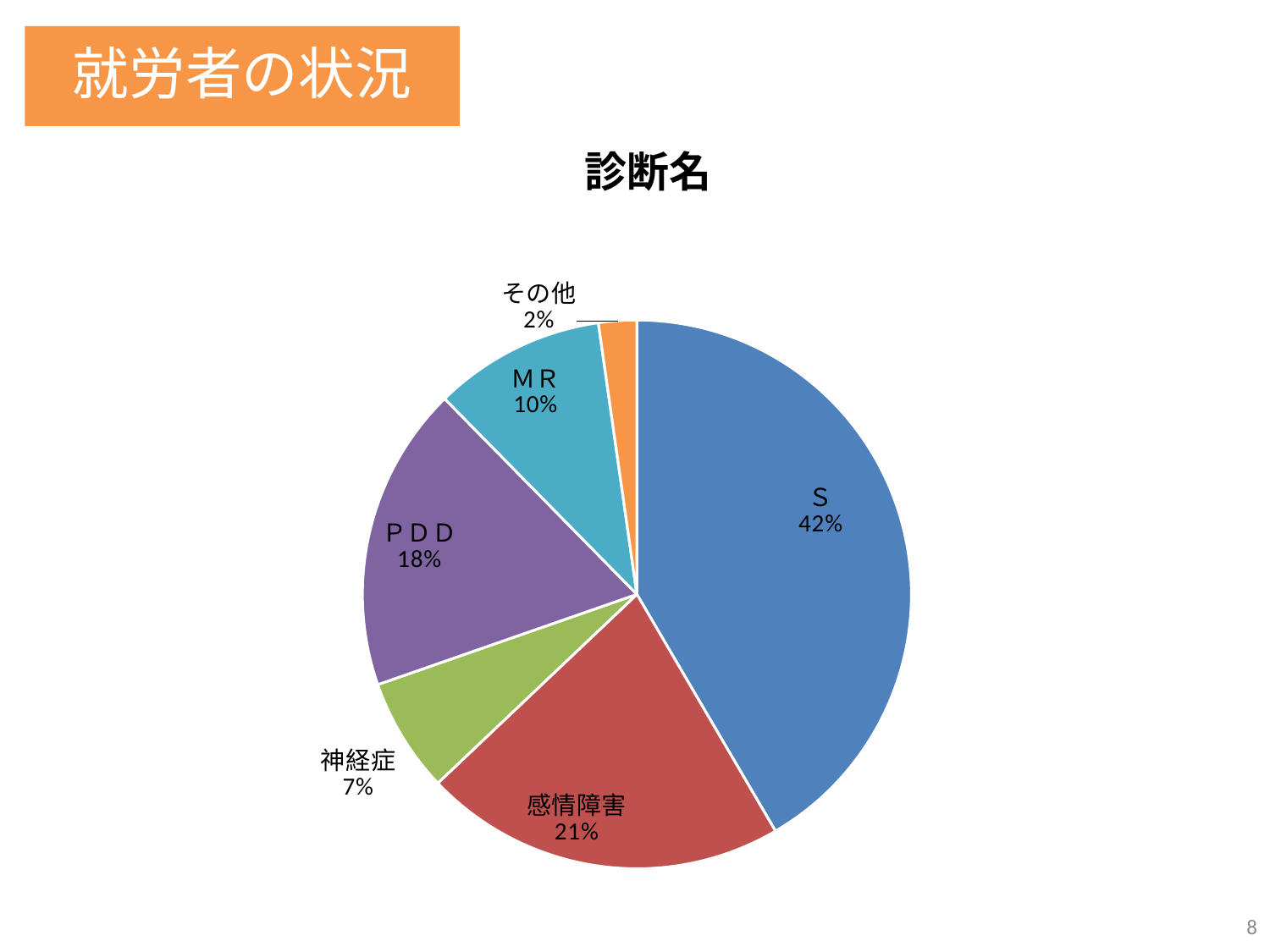
What is the title of the chart? 診断名 How many slices does the pie chart have? 6 What percentage does the 感情障害 slice represent? 21% What percentage does the S slice represent? 42% Which is larger, the share for MR or the share for 神経症? MR What percentage does the 神経症 slice represent? 7% What kind of chart is shown on the slide? pie chart Which category has the largest share of the pie? S What colour is the S slice? blue What percentage does the PDD slice represent? 18% Which category has the smallest share of the pie? その他 What is the difference in percentage points between S and 感情障害? 21